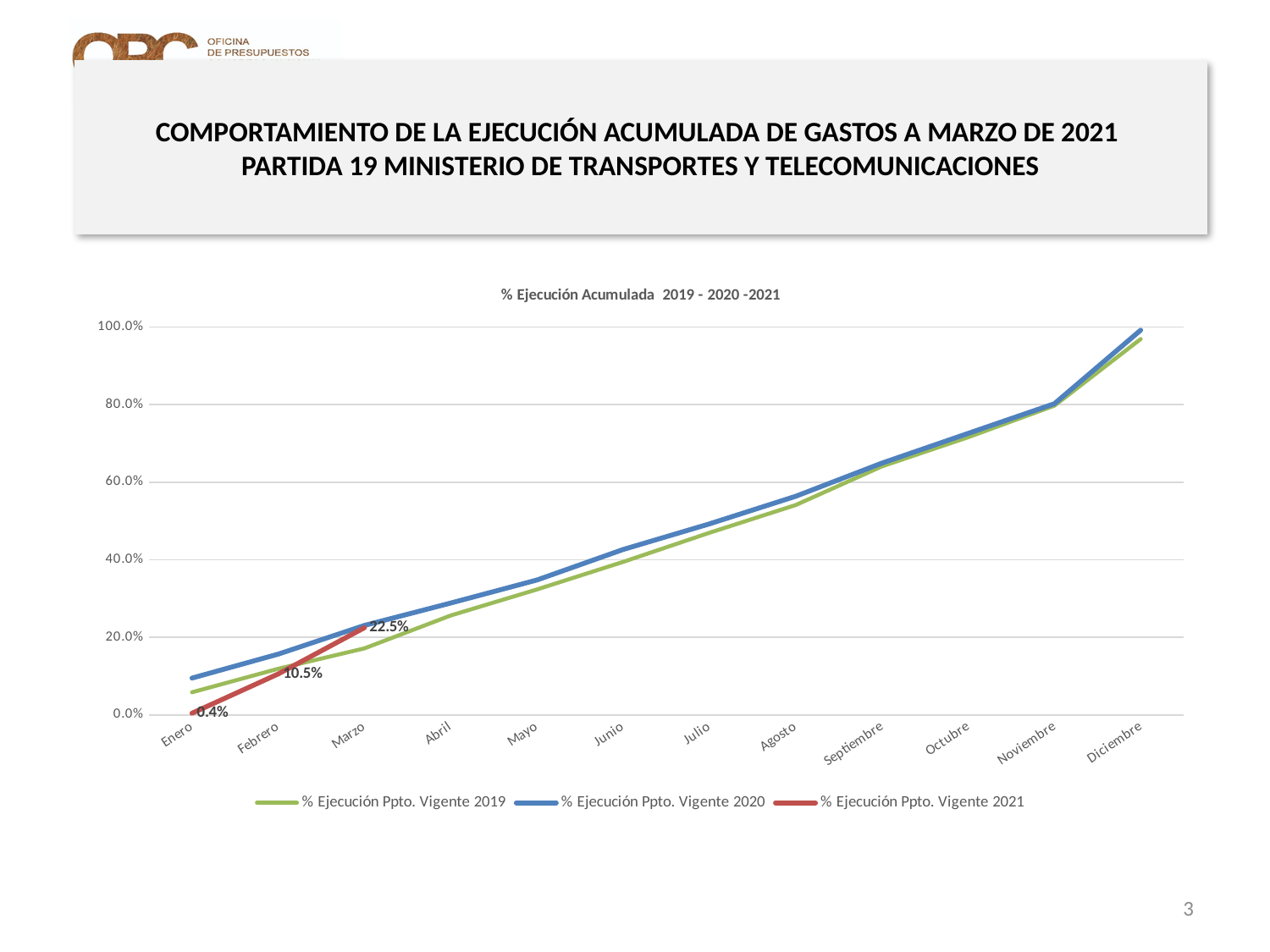
What kind of chart is shown on the slide? Line chart In Marzo, which series has the larger value: % Ejecución Ppto. Vigente 2019 or % Ejecución Ppto. Vigente 2020? % Ejecución Ppto. Vigente 2020 Is the value for % Ejecución Ppto. Vigente 2019 in Agosto greater or less than 60.0%? less Do the values for % Ejecución Ppto. Vigente 2020 rise or fall from Enero to Diciembre? Rise What is the difference between the 2021 values for Marzo and Febrero? 12.0% Is the value for % Ejecución Ppto. Vigente 2020 in Enero greater or less than 20.0%? less How many months are shown on the x axis of the chart? 12 Is the value for % Ejecución Ppto. Vigente 2020 in Diciembre greater or less than 80.0%? greater What is the value of % Ejecución Ppto. Vigente 2021 for Enero? 0.4% How many series does the legend list? 3 What is the value of % Ejecución Ppto. Vigente 2021 for Marzo? 22.5% What is the value of % Ejecución Ppto. Vigente 2021 for Febrero? 10.5%